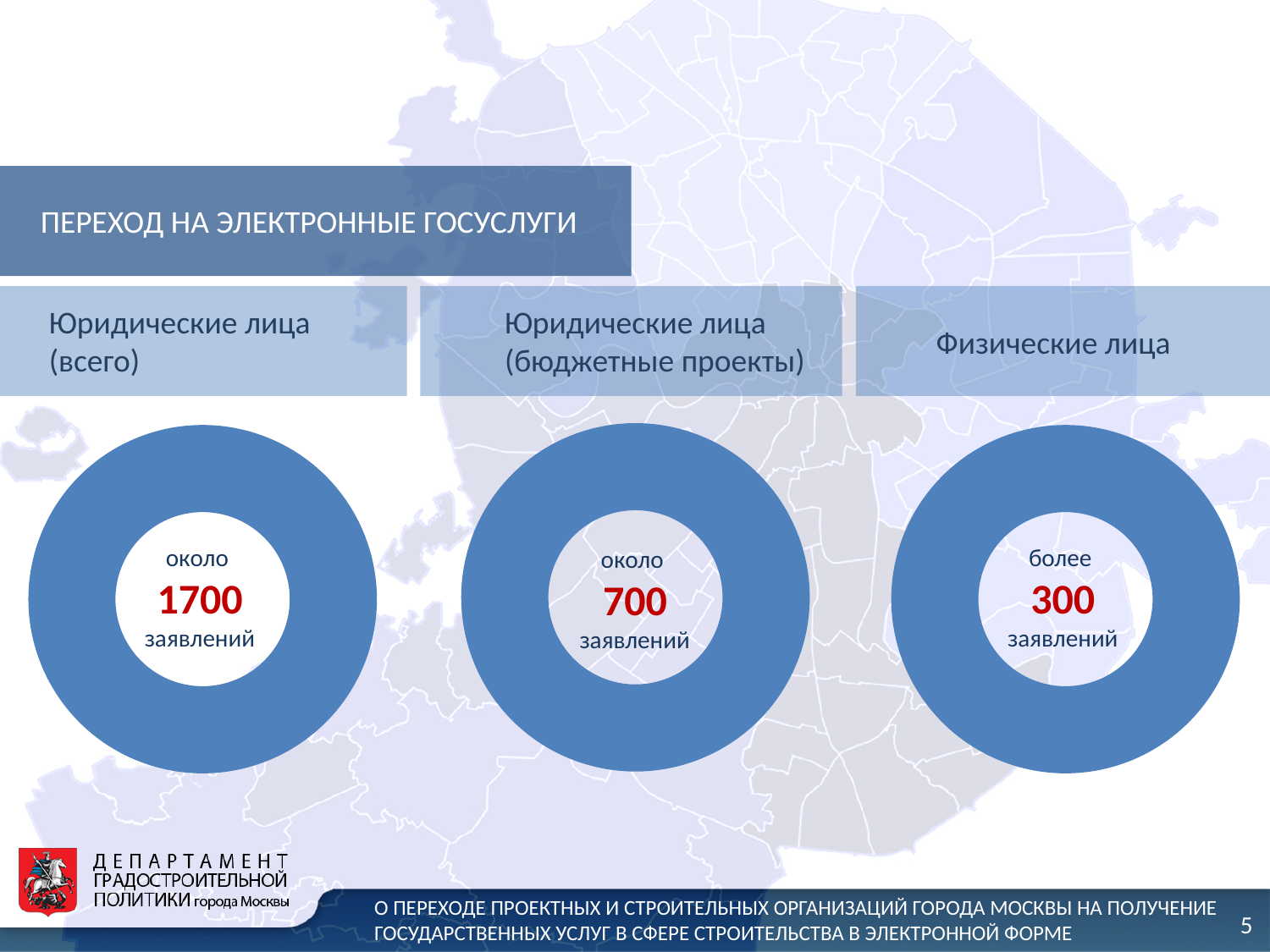
What number is shown in the ring for Физические лица? более 300 заявлений What colour are the three rings? Blue How many ring graphics are shown on the slide? 3 Which category shows the smallest number of заявлений? Физические лица What number is shown in the ring for Юридические лица (бюджетные проекты)? около 700 заявлений Which category shows the largest number of заявлений? Юридические лица (всего) What number is shown in the ring for Юридические лица (всего)? около 1700 заявлений Which is larger: the number for Юридические лица (бюджетные проекты) or for Физические лица? Юридические лица (бюджетные проекты) What is the title of the section containing the three rings? ПЕРЕХОД НА ЭЛЕКТРОННЫЕ ГОСУСЛУГИ